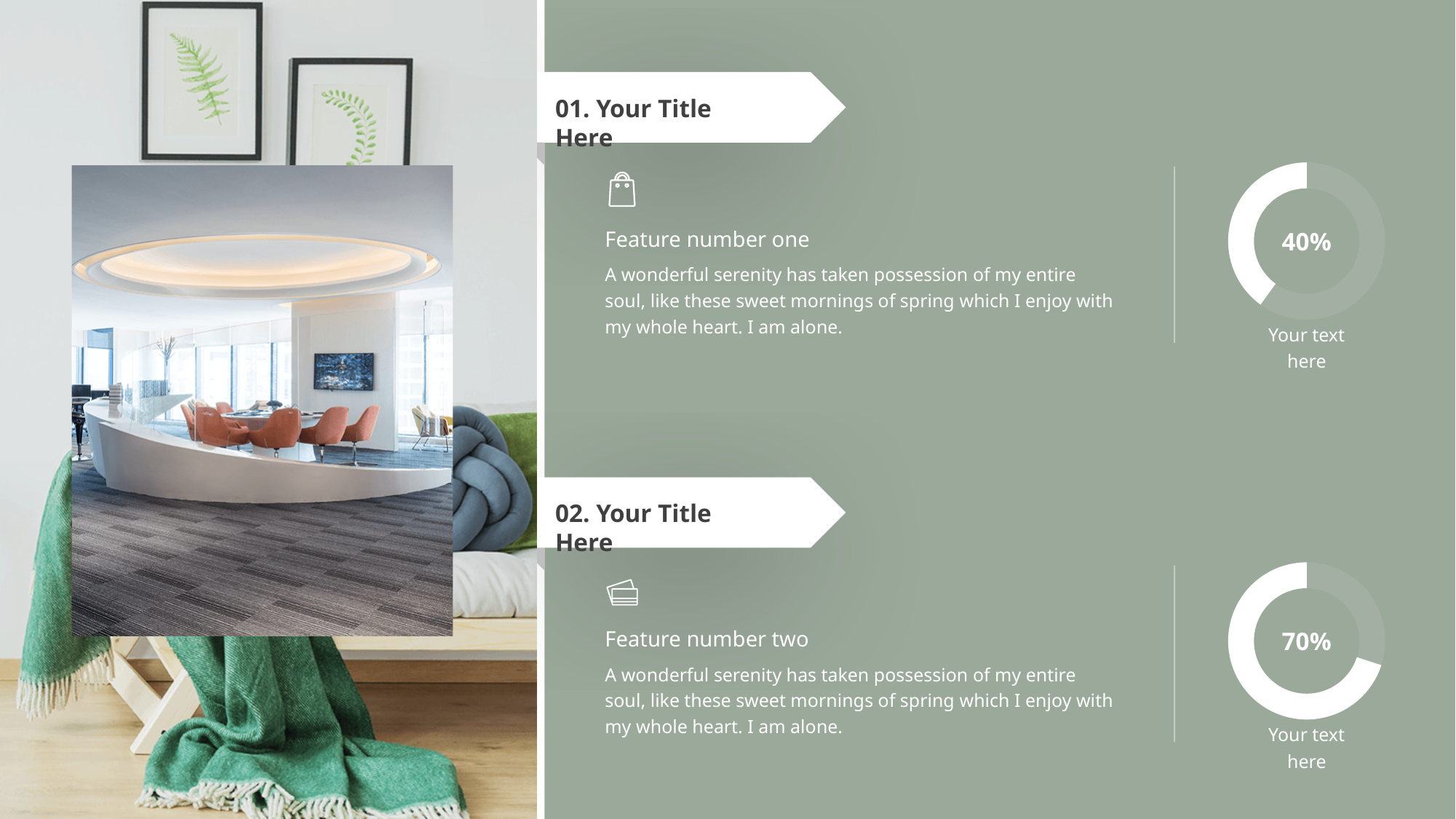
What percentage is shown in the centre of the top donut chart, next to "Feature number one"? 40% Is the value shown in the top donut chart greater or less than 50%? less Which donut chart shows the smaller percentage, the top one or the bottom one? the top one What caption text appears below each donut chart? Your text here What percentage is shown in the centre of the bottom donut chart, next to "Feature number two"? 70% How many donut charts are on the slide? 2 In the bottom donut chart, what share of the ring is filled in white? 70% What is the difference in percentage points between the bottom donut chart (70%) and the top donut chart (40%)? 30 percentage points Which donut chart shows the larger percentage, the top one or the bottom one? the bottom one What kind of chart is used on the right side of the slide to show the 40% and 70% values? donut chart Is the value shown in the bottom donut chart greater or less than 50%? greater In the top donut chart, what share of the ring is filled in white? 40%